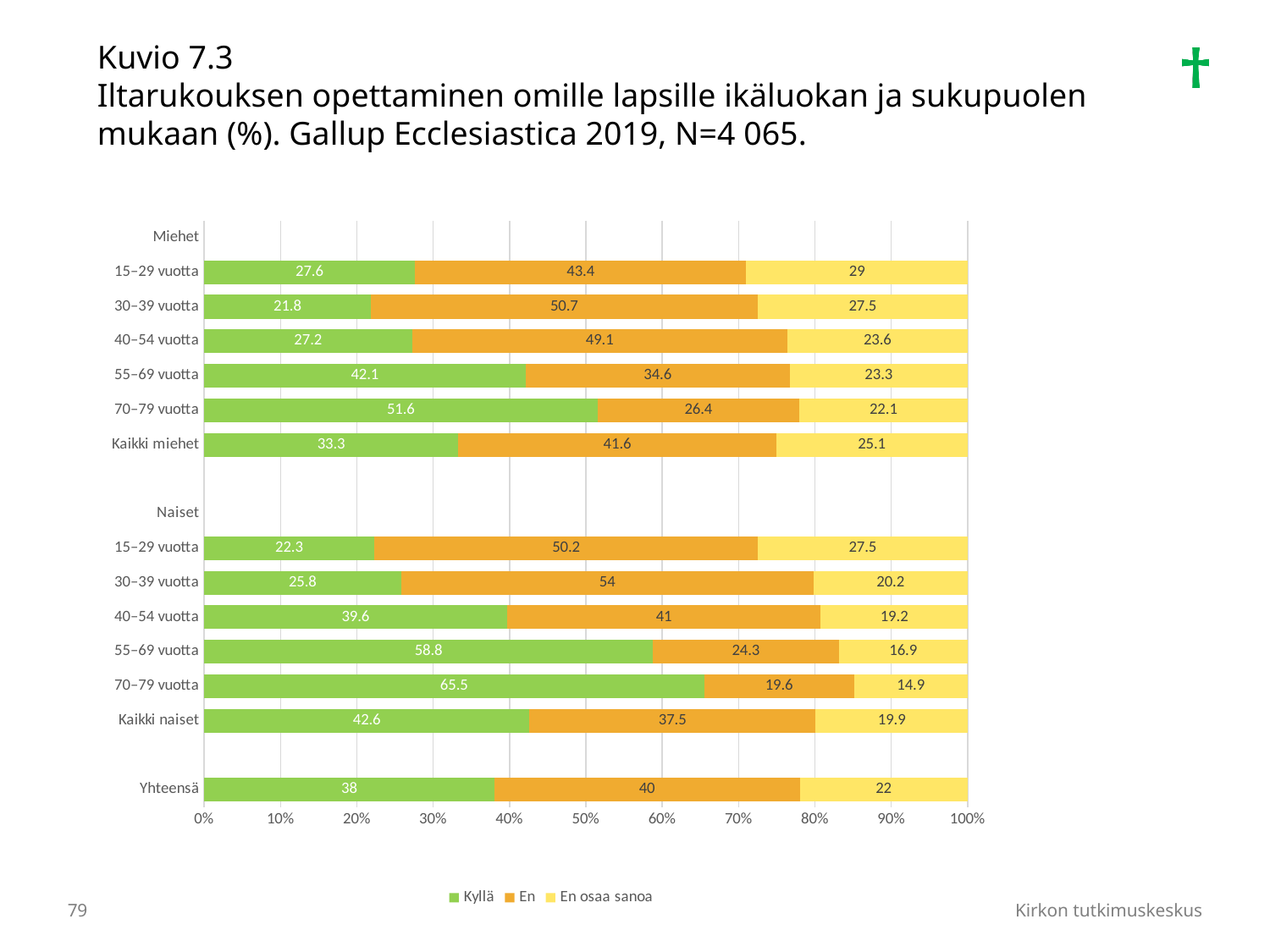
Which category has the highest En value? Naiset 30–39 vuotta What is the Kyllä value for the Yhteensä bar? 38 What kind of chart is shown on the slide? Stacked bar chart What is the En osaa sanoa value for Kaikki miehet? 25.1 What is the difference between the Kyllä value for Kaikki naiset and the Kyllä value for Kaikki miehet? 9.3 What is the total of the Yhteensä stacked bar? 100 Which category has the highest Kyllä value? Naiset 70–79 vuotta What is the En value for men (Miehet) aged 30–39 vuotta? 50.7 Which is larger: the Kyllä value for men aged 55–69 vuotta or the Kyllä value for women aged 55–69 vuotta? Women aged 55–69 vuotta What is the Kyllä value for women (Naiset) aged 70–79 vuotta? 65.5 How many series does the legend list? 3 Which category has the lowest Kyllä value? Miehet 30–39 vuotta